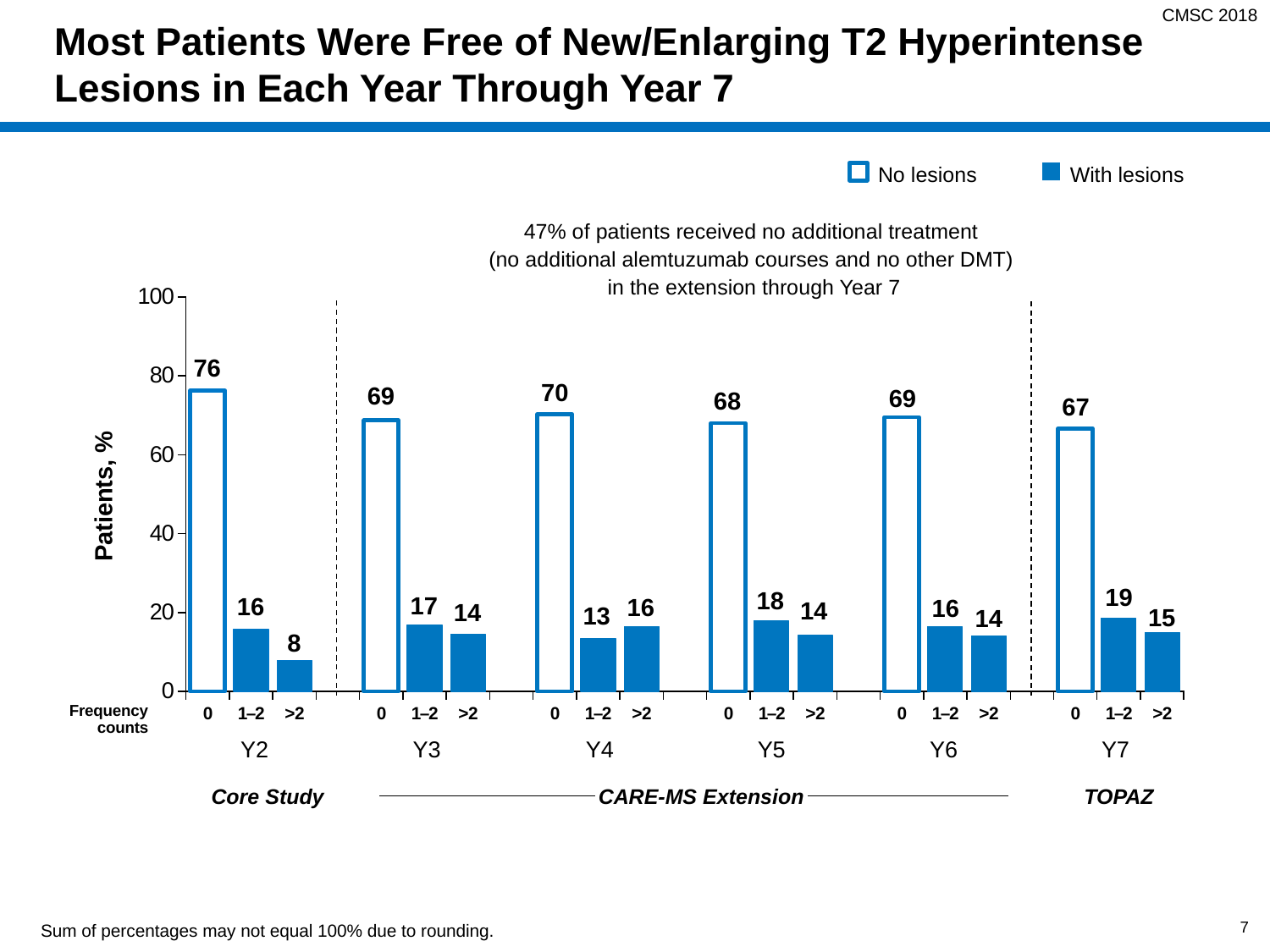
What is the label of the y axis? Patients, % What percentage of patients had >2 lesions in Y2? 8 What kind of chart is shown on the slide? Bar chart How many series does the legend list? 2 In which year is the percentage of patients with no lesions (count 0) lowest? Y7 What is the difference between the no-lesions percentage in Y2 and in Y7? 9 What percentage of patients had 1–2 lesions in Y7? 19 Is the value for no lesions in Y4 greater or less than 60? greater Which is larger: the percentage with 1–2 lesions in Y5 or the percentage with 1–2 lesions in Y4? Y5 In which year is the percentage of patients with no lesions (count 0) highest? Y2 How many years (Y2 through Y7) are shown on the x axis? 6 What percentage of patients had no lesions (frequency count 0) in Y2? 76